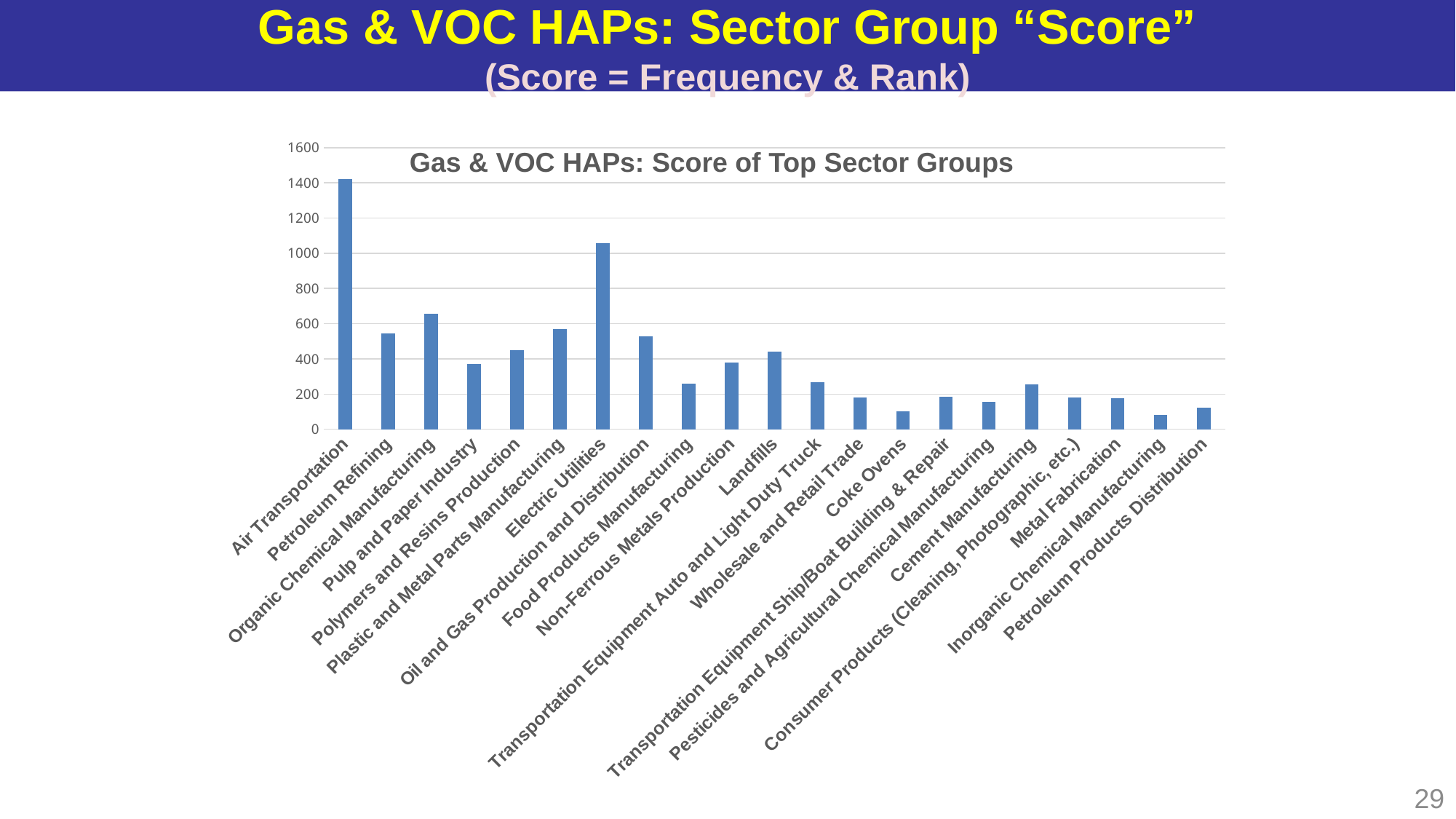
Is the score for Air Transportation greater or less than 1200? greater Which has a higher score, Organic Chemical Manufacturing or Plastic and Metal Parts Manufacturing? Organic Chemical Manufacturing Which sector group has the highest score? Air Transportation Is the score for Electric Utilities greater or less than 1000? greater Is the score for Pulp and Paper Industry greater or less than 400? less Which has a higher score, Electric Utilities or Petroleum Refining? Electric Utilities Which has a higher score, Landfills or Food Products Manufacturing? Landfills How many sector groups are plotted on the chart? 21 Which sector group has the lowest score? Inorganic Chemical Manufacturing What kind of chart is shown on the slide? Bar chart What is the title of the chart? Gas & VOC HAPs: Score of Top Sector Groups